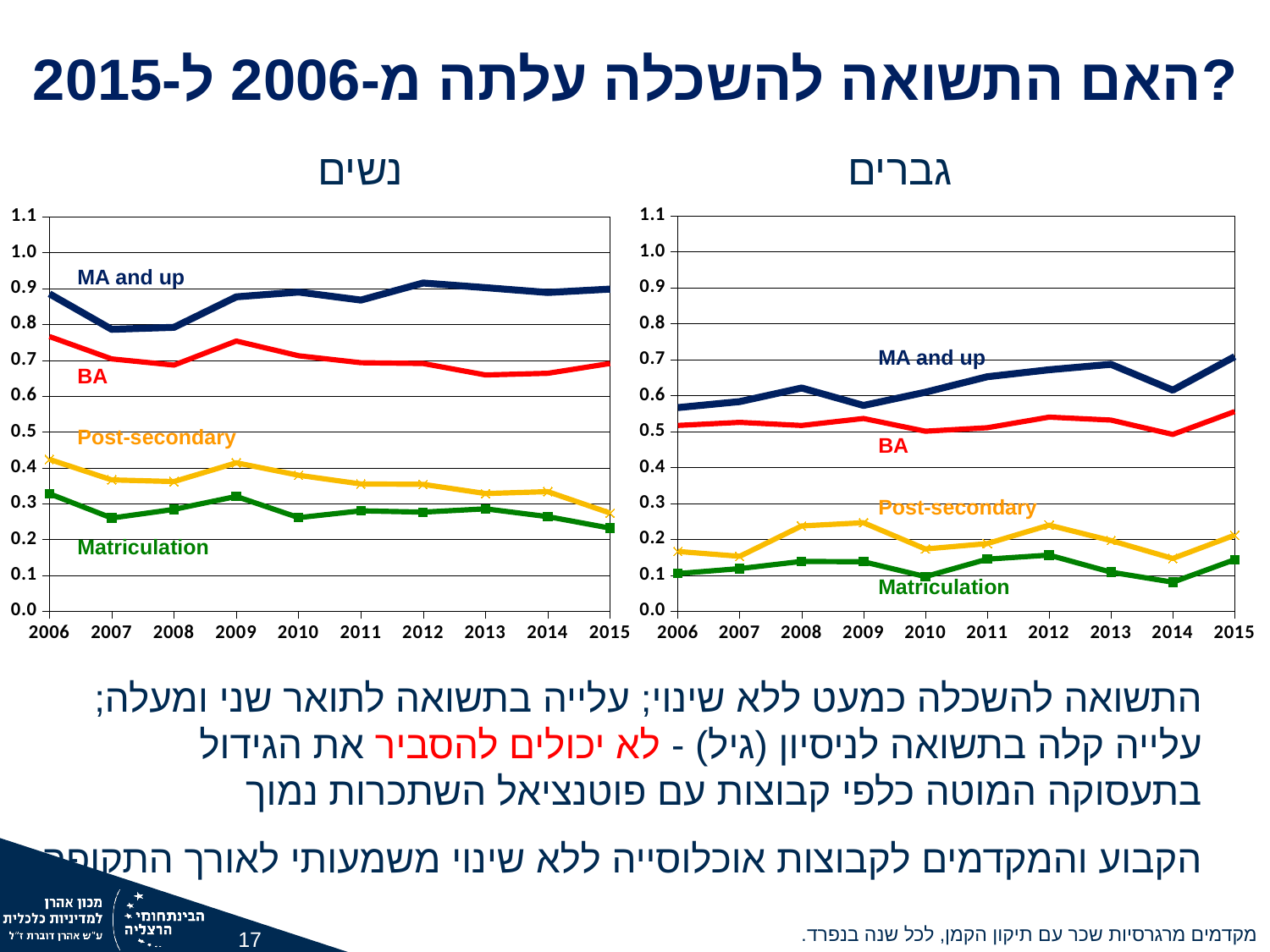
In the right chart (גברים), does the MA and up series overall rise or fall from 2006 to 2015? rise What kind of chart is the left chart (נשים)? line chart In the right chart (גברים), which series has the lowest value in 2014? Matriculation How many years are plotted along the x axis of the right chart (גברים)? 10 Which is larger: the BA value in 2006 in the left chart (נשים) or the BA value in 2006 in the right chart (גברים)? left chart (נשים) How many labelled series are shown in the left chart (נשים)? 4 In the right chart (גברים), is the value for MA and up in 2015 greater or less than 0.6? greater In the left chart (נשים), is the value for Post-secondary in 2015 greater or less than 0.4? less In the right chart (גברים), is the value for BA in 2006 greater or less than 0.6? less In the left chart (נשים), which series has the highest value in 2015? MA and up In the left chart (נשים), does the Post-secondary series overall rise or fall from 2006 to 2015? fall